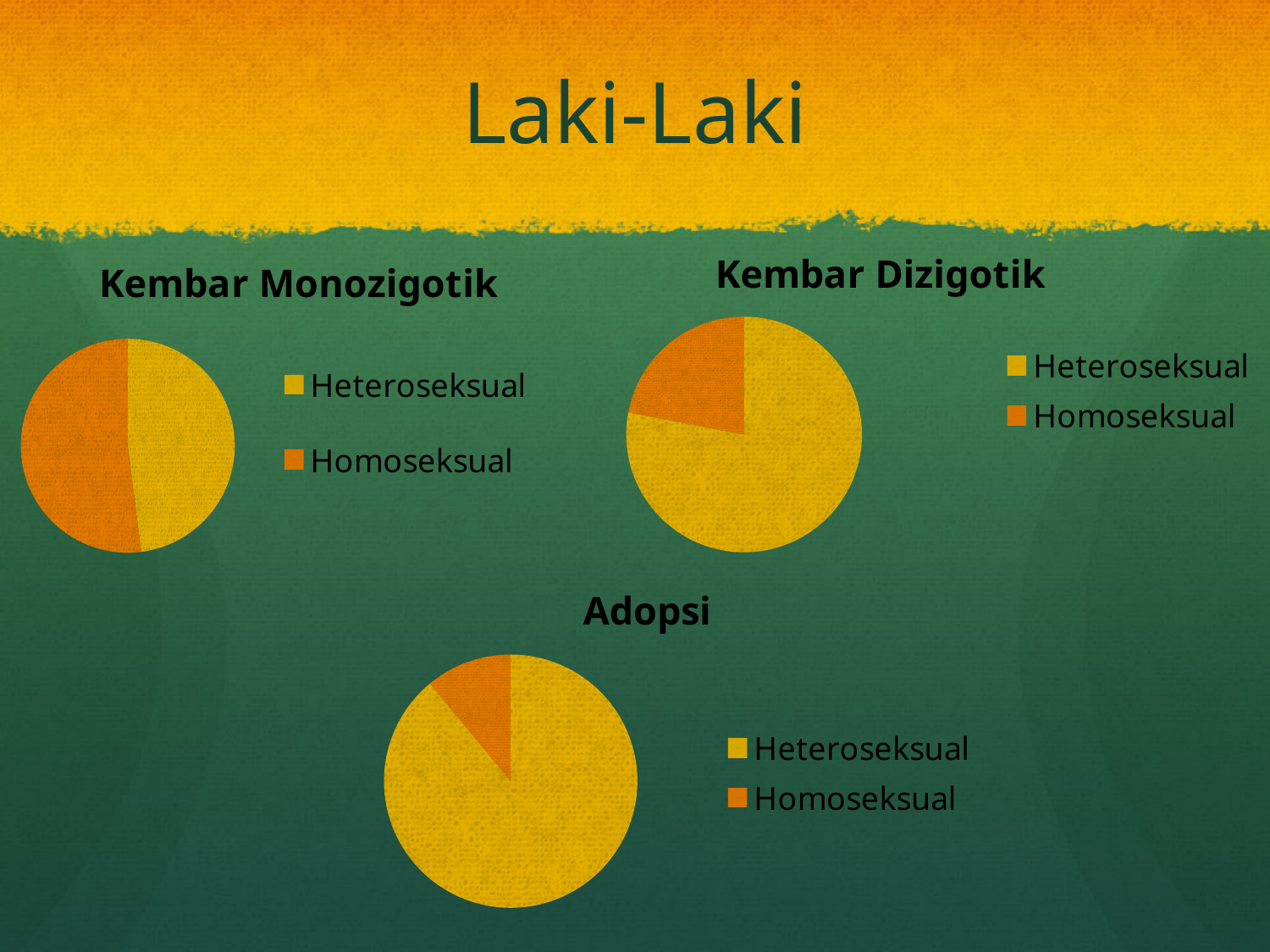
Which colour represents Homoseksual in the Adopsi chart? orange In the Adopsi chart, which category has the smallest slice? Homoseksual In the Kembar Dizigotik chart, which slice is larger, Heteroseksual or Homoseksual? Heteroseksual In the Kembar Dizigotik chart, which category has the largest slice? Heteroseksual What kind of chart is used for Kembar Monozigotik? pie chart What is the title of the slide? Laki-Laki How many charts are shown on the slide? 3 How many categories does the legend of the Kembar Dizigotik chart list? 2 What kind of chart is used for Adopsi? pie chart How many slices does the Adopsi pie chart have? 2 In the Adopsi chart, which slice is larger, Heteroseksual or Homoseksual? Heteroseksual